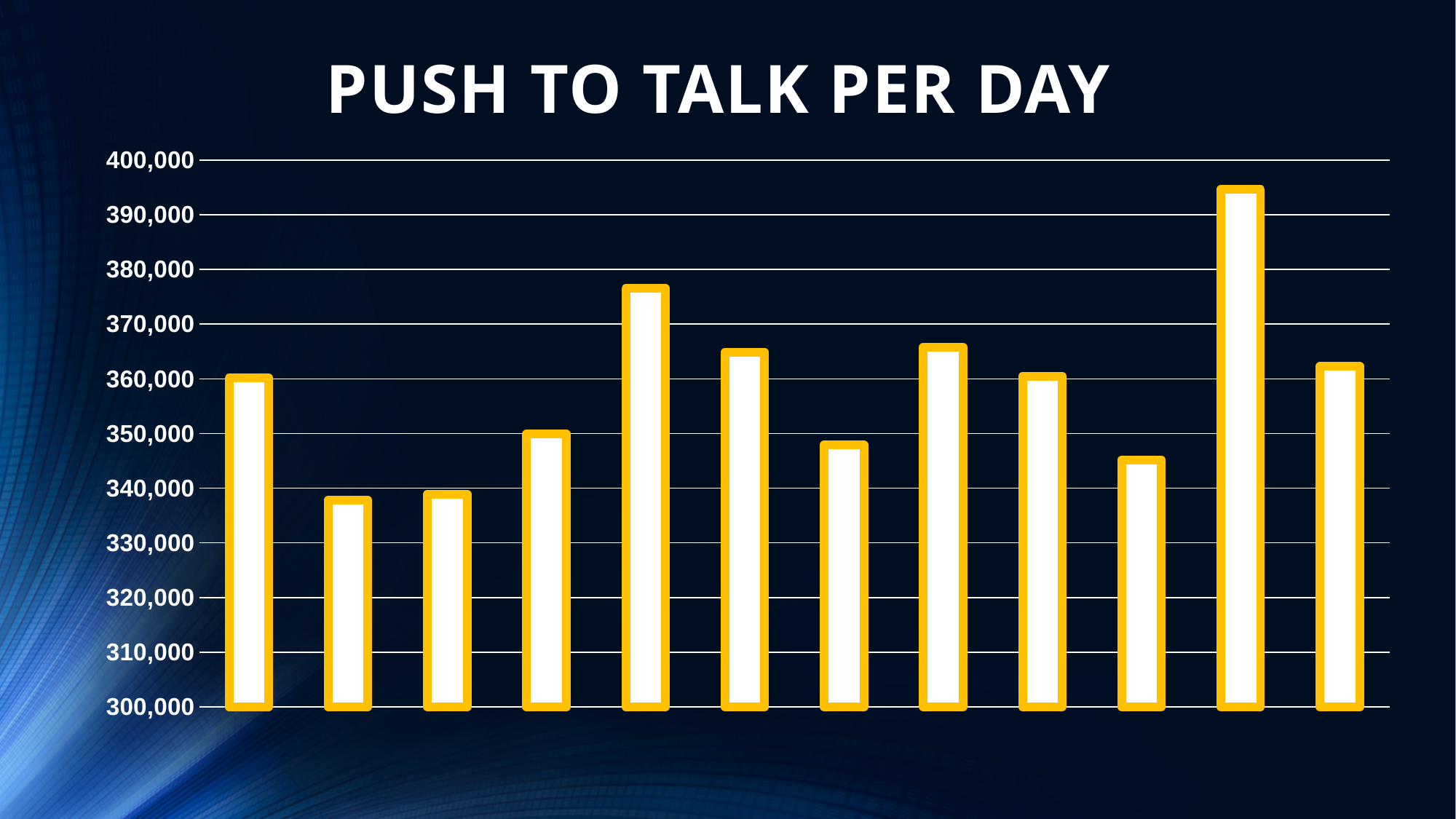
What is the title of the chart? PUSH TO TALK PER DAY Is the value of the sixth bar from the left greater or less than 360,000? greater Is the value of the fifth bar from the left greater or less than 370,000? greater Which is larger, the second bar from the left or the tenth bar from the left? The tenth bar Is the value of the tenth bar from the left greater or less than 350,000? less What kind of chart is shown on the slide? Bar chart Which is larger, the fifth bar from the left or the sixth bar from the left? The fifth bar Which bar, counting from the left, is the tallest? The 11th bar What is the highest value shown on the vertical axis? 400,000 How many bars are plotted in the chart? 12